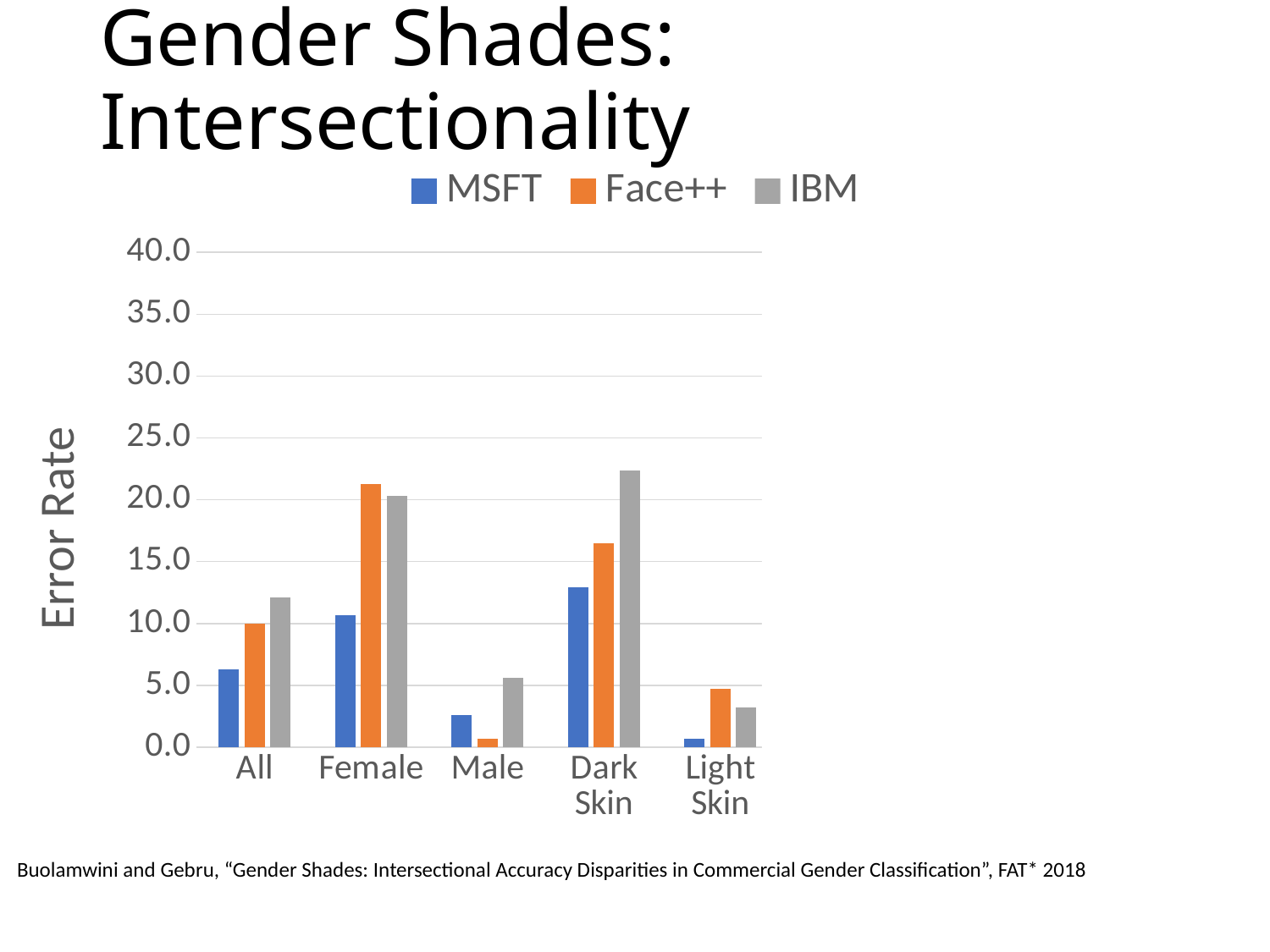
For Male, which has the higher error rate, MSFT or IBM? IBM For which category is the MSFT error rate lowest? Light Skin How many categories are shown on the x axis? 5 What is the label on the y axis? Error Rate For which category is the Face++ error rate highest? Female What kind of chart is shown on the slide? bar chart For Dark Skin, which has the higher error rate, Face++ or IBM? IBM For which category is the IBM error rate highest? Dark Skin How many series does the legend list? 3 Is the MSFT error rate for Dark Skin greater or less than 10.0? greater Is the Face++ error rate for Male greater or less than 5.0? less Is the IBM error rate for Dark Skin greater or less than 20.0? greater